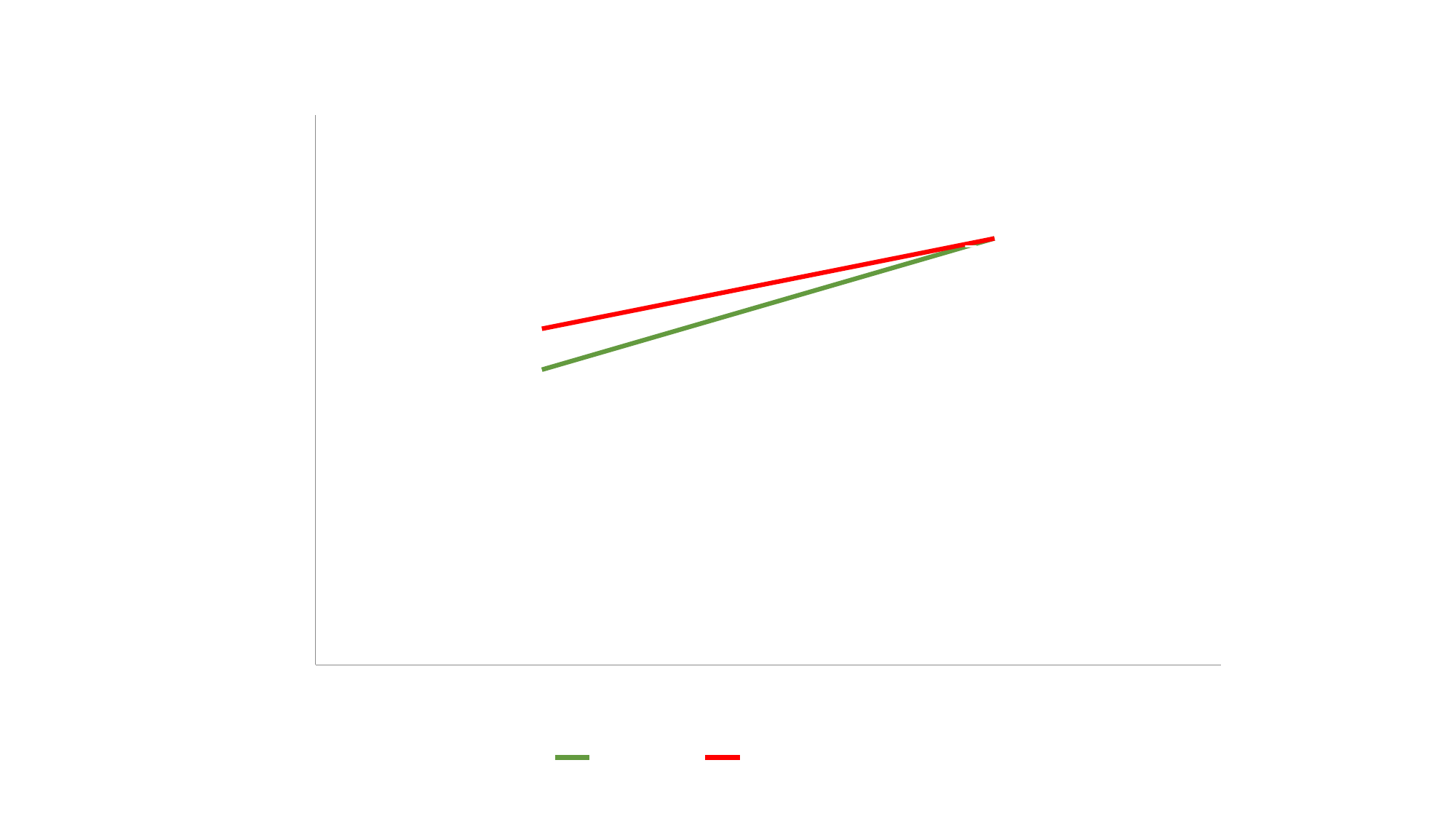
Where is the legend positioned relative to the plot area? below How many lines are plotted on the chart? 2 At the left end of the lines, which line is higher, the green or the red? red What kind of chart is shown on the slide? line chart What colours are the two lines on the chart? green and red Does the red line rise or fall from left to right? rise Does the green line rise or fall from left to right? rise Which line has the steeper slope, the green or the red? green How many series does the legend list? 2